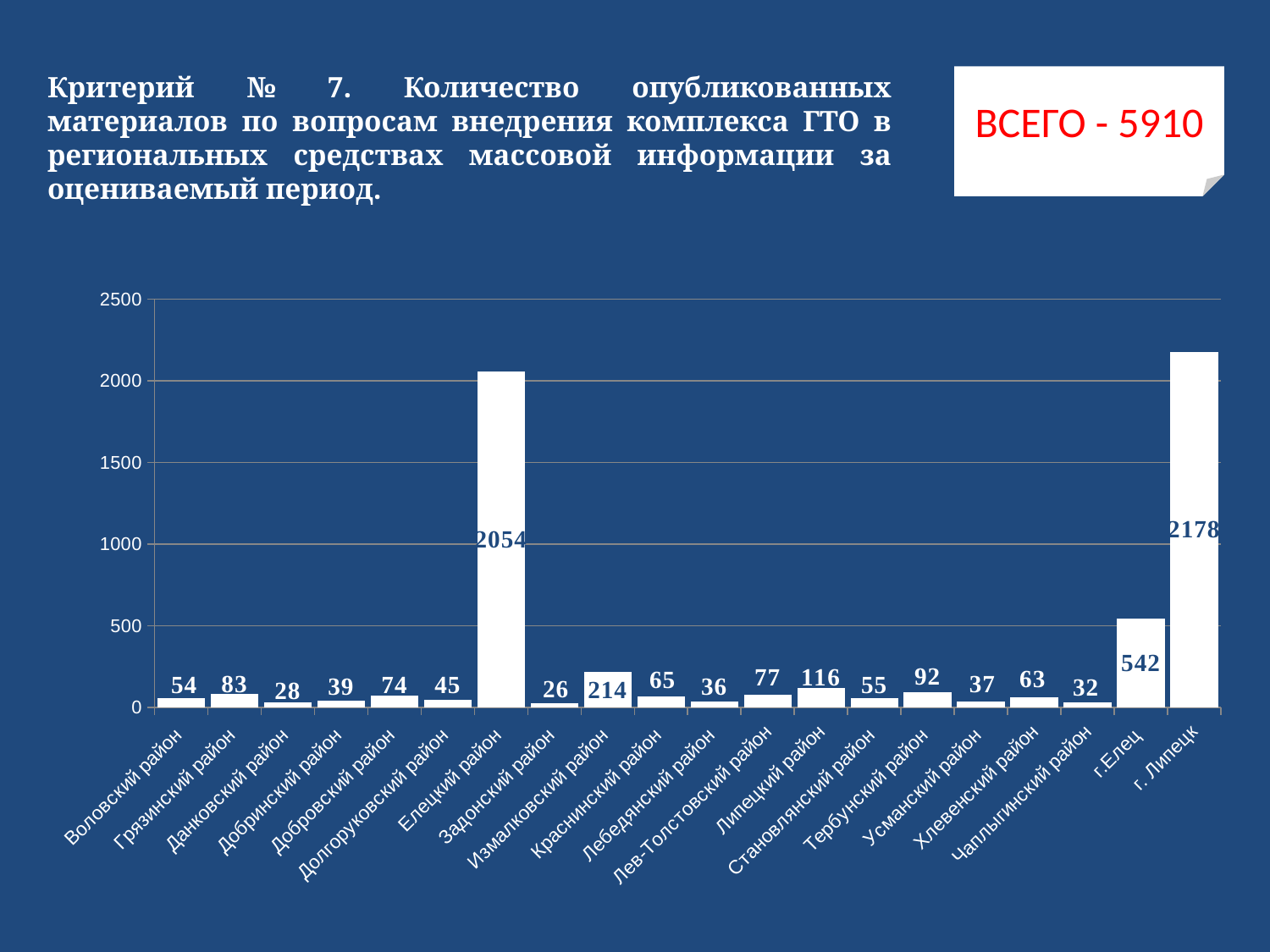
What is the value for Измалковский район? 214 What is the value for г.Елец? 542 What is the value for Липецкий район? 116 Which is larger, the value for Грязинский район or the value for Тербунский район? Тербунский район What total (ВСЕГО) is shown in the box at the top right of the slide? 5910 Which category has the lowest value? Задонский район What is the difference between the values for г. Липецк and Елецкий район? 124 Is the value for г.Елец greater or less than 500? greater Which category has the highest value? г. Липецк How many categories (districts and cities) are shown on the x axis of the chart? 20 What kind of chart is shown on the slide? bar chart What is the value for Елецкий район? 2054